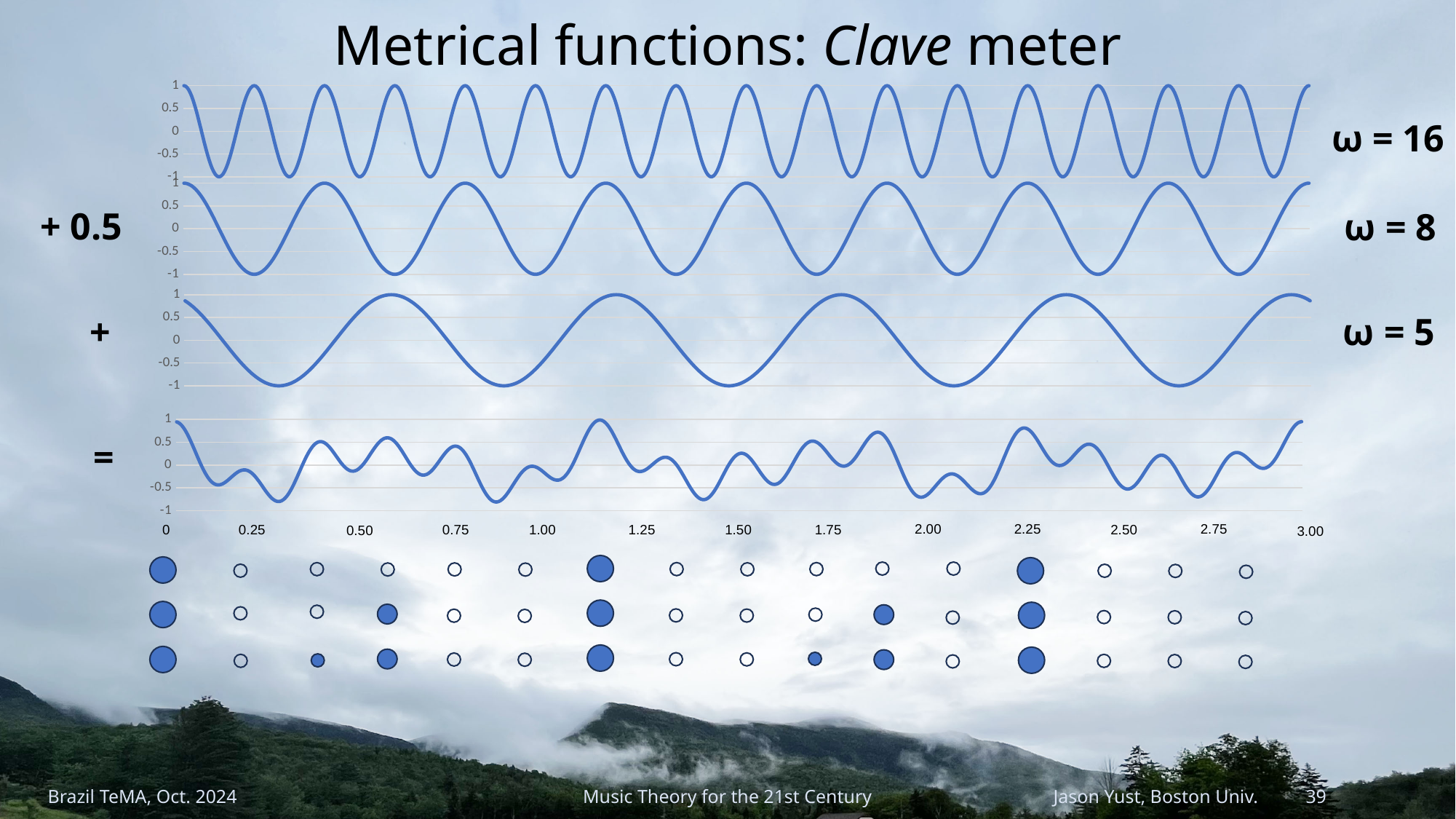
In the bottom (=) chart, is the value at x = 0 greater or less than 0.5? greater What is the lowest value shown on the y axis of the ω = 5 chart? -1 How many x-axis tick labels are shown under the bottom (=) chart? 13 How many line charts are stacked on the slide? 4 Which of the three component waves has the most cycles across the x axis: ω = 16, ω = 8, or ω = 5? ω = 16 What kind of chart is used for the ω = 16 plot at the top of the slide? line chart What coefficient is written to the left of the ω = 8 chart? + 0.5 What is the highest value shown on the y axis of the ω = 8 chart? 1 What is the value of the ω = 16 wave at x = 0? 1 What is the last x-axis label on the bottom (=) chart? 3.00 What is the value of the ω = 8 wave at x = 0? 1 In the ω = 5 chart, is the value at x = 0.25 greater or less than 0? less